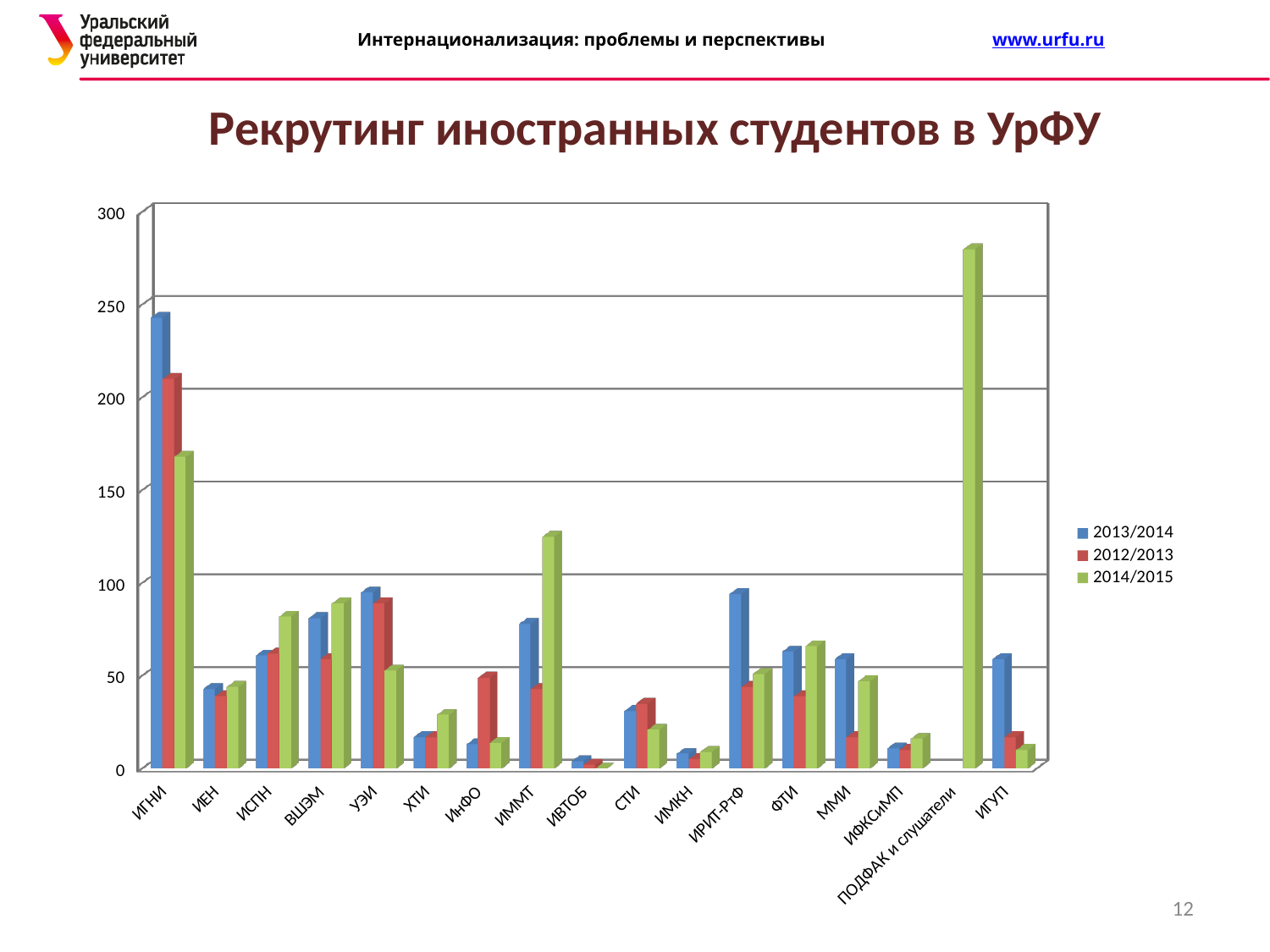
Is the 2013/2014 value for ХТИ greater or less than 50? less Is the 2013/2014 value for ИГНИ greater or less than 200? greater How many series does the legend list? 3 How many categories are shown on the x axis? 17 Which category has the tallest bar in the whole chart? ПОДФАК и слушатели Which category has the highest value for the 2012/2013 series? ИГНИ Is the 2014/2015 value for ПОДФАК и слушатели greater or less than 250? greater Which category has the highest value for the 2013/2014 series? ИГНИ For ИММТ, which is larger: the 2014/2015 value or the 2013/2014 value? 2014/2015 What kind of chart is shown on the slide? bar chart For ИГНИ, which is larger: the 2013/2014 value or the 2012/2013 value? 2013/2014